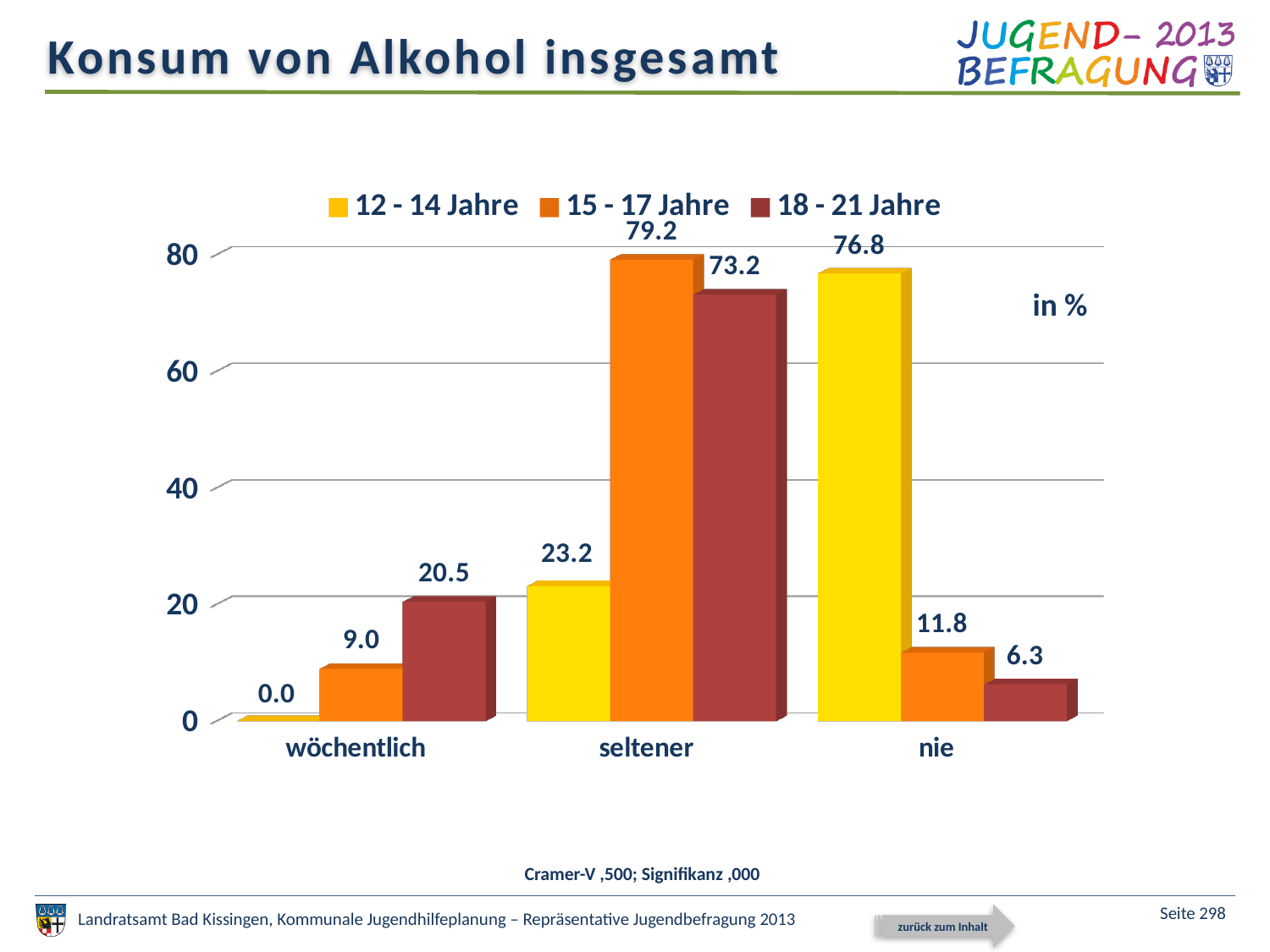
How many categories are shown on the x axis? 3 What is the value for 12 - 14 Jahre in the wöchentlich category? 0.0 Is the value for 12 - 14 Jahre in the seltener category greater or less than 40? less Which is larger in the nie category: the value for 15 - 17 Jahre or for 18 - 21 Jahre? 15 - 17 Jahre What is the difference between the 15 - 17 Jahre and 18 - 21 Jahre values in the seltener category? 6.0 Which age group has the highest value in the seltener category? 15 - 17 Jahre How many series does the legend list? 3 What is the value for 12 - 14 Jahre in the nie category? 76.8 What is the value for 18 - 21 Jahre in the wöchentlich category? 20.5 What is the value for 15 - 17 Jahre in the seltener category? 79.2 What kind of chart is shown on the slide? bar chart Which age group has the lowest value in the nie category? 18 - 21 Jahre